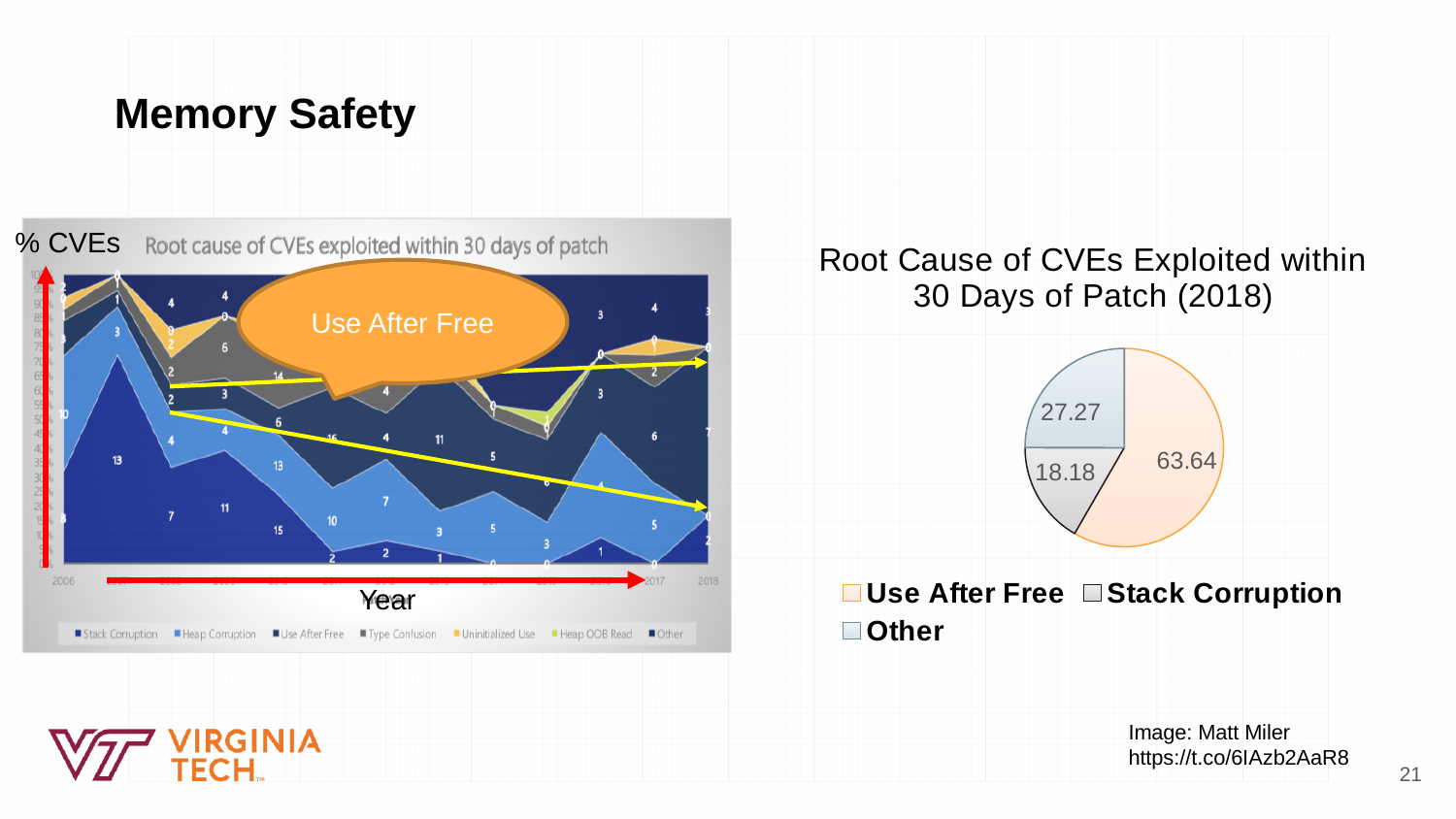
How many categories does the legend of the pie chart on the right list? 3 What is the title of the pie chart on the right? Root Cause of CVEs Exploited within 30 Days of Patch (2018) In the pie chart on the right, which is larger: the Other slice or the Stack Corruption slice? Other In the pie chart on the right, which category has the largest slice? Use After Free How many series does the legend of the chart on the left list? 7 In the pie chart on the right, what is the difference between the Use After Free value and the Other value? 36.37 In the pie chart on the right, what is the value shown for the Other slice? 27.27 In the pie chart on the right, which category has the smallest slice? Stack Corruption What kind of chart is the chart on the right of the slide? Pie chart In the pie chart on the right, what is the value shown for the Stack Corruption slice? 18.18 What label is written along the horizontal axis of the chart on the left? Year In the pie chart on the right, what is the value shown for the Use After Free slice? 63.64